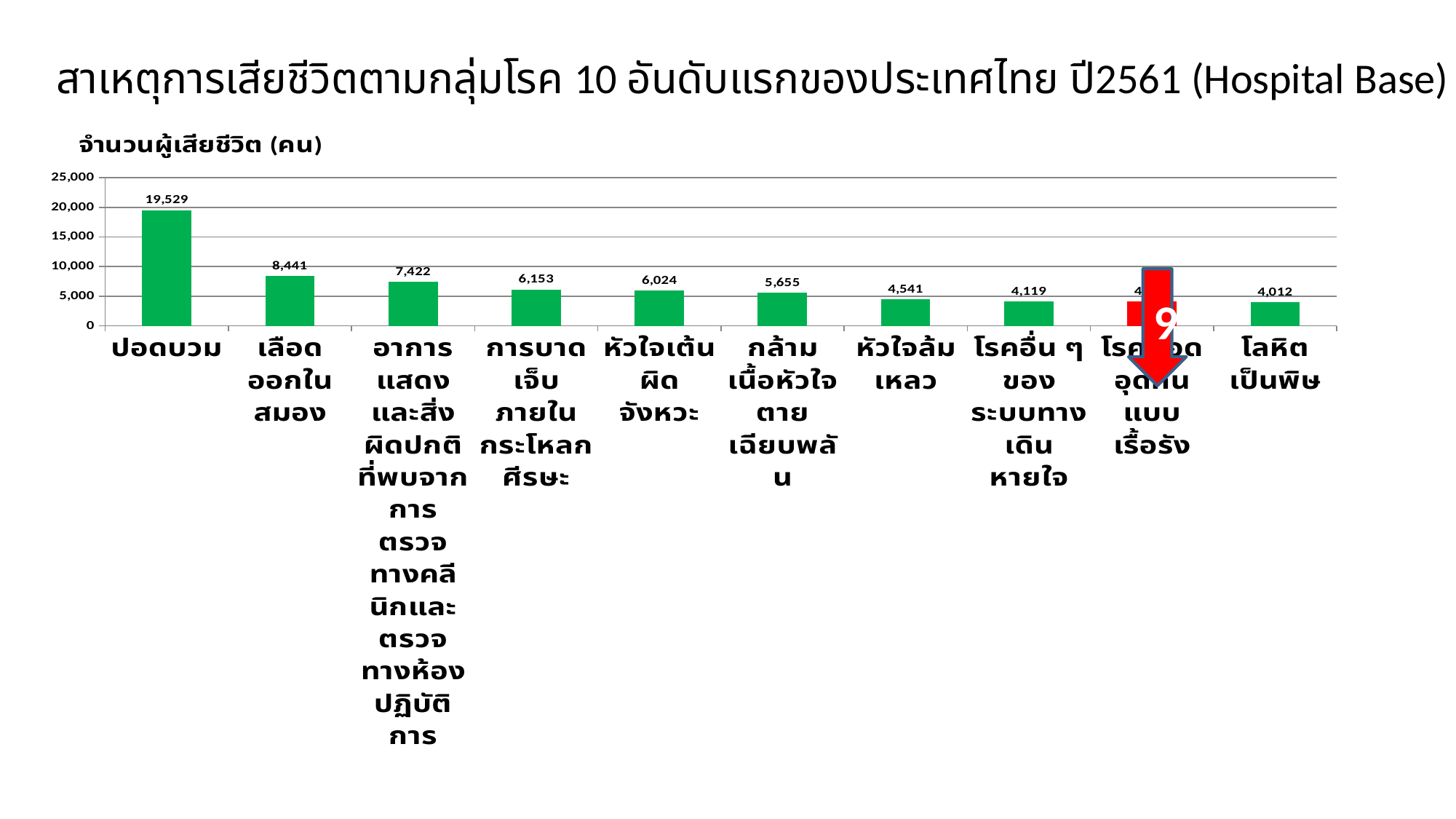
What is the difference in deaths between ปอดบวม and เลือดออกในสมอง? 11,088 What is the number of deaths for หัวใจเต้นผิดจังหวะ? 6,024 Which disease group has the highest number of deaths? ปอดบวม What is the number of deaths for โลหิตเป็นพิษ? 4,012 Is the value for หัวใจล้มเหลว greater or less than 5,000? less What is the axis title shown above the vertical axis of the chart? จำนวนผู้เสียชีวิต (คน) What is the number of deaths for เลือดออกในสมอง? 8,441 How many categories (disease groups) are plotted in the chart? 10 Do the values generally rise or fall from left to right across the chart? fall What is the number of deaths for ปอดบวม? 19,529 What type of chart is shown on the slide? Bar chart Which has more deaths: การบาดเจ็บภายในกระโหลกศีรษะ or กล้ามเนื้อหัวใจตายเฉียบพลัน? การบาดเจ็บภายในกระโหลกศีรษะ